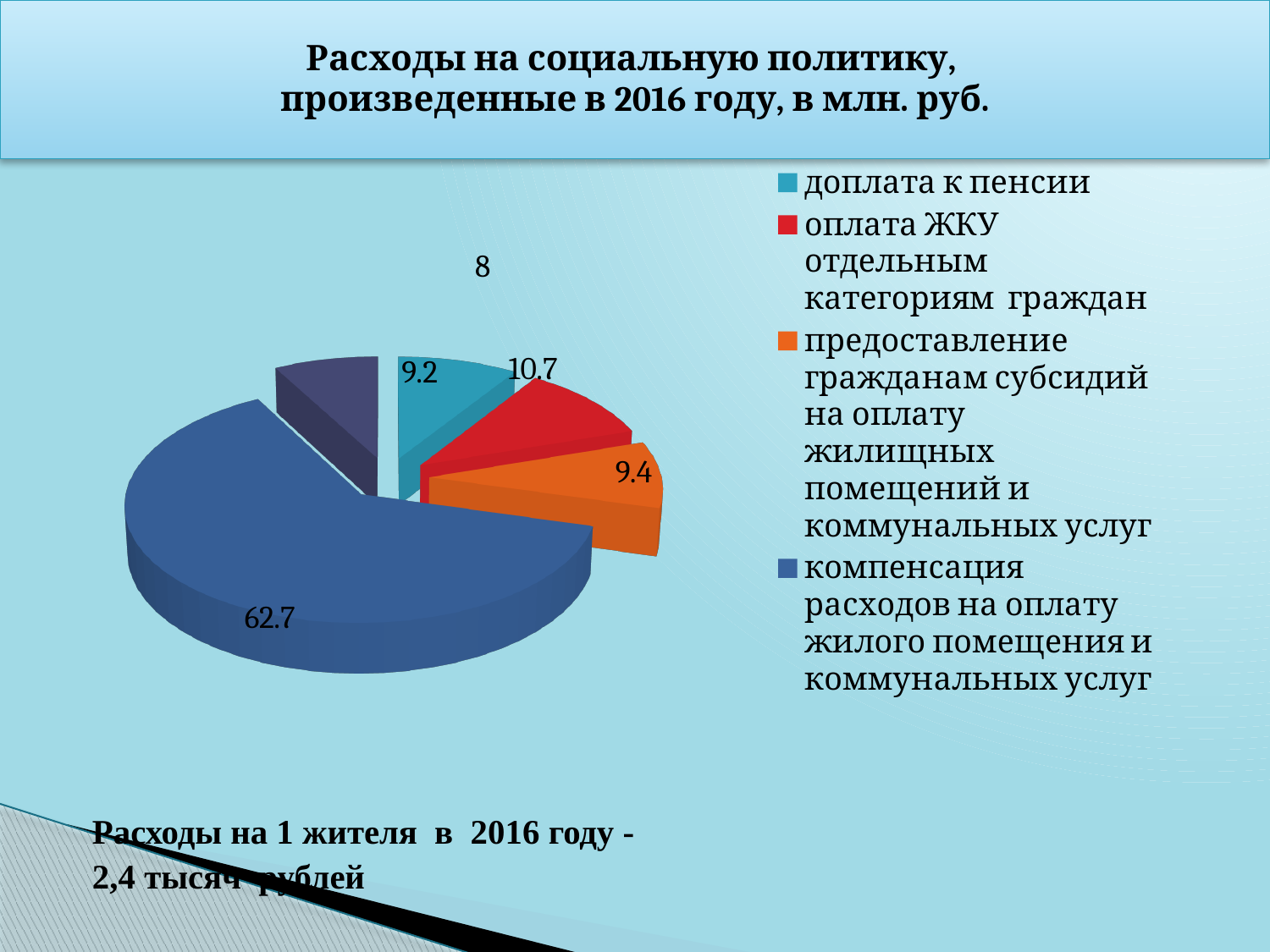
Which is larger: "оплата ЖКУ отдельным категориям граждан" or "предоставление гражданам субсидий на оплату жилищных помещений и коммунальных услуг"? оплата ЖКУ отдельным категориям граждан What is the difference between the values for "оплата ЖКУ отдельным категориям граждан" and "доплата к пенсии"? 1.5 What is the difference between the values for "компенсация расходов на оплату жилого помещения и коммунальных услуг" and "оплата ЖКУ отдельным категориям граждан"? 52 How many categories does the legend list? 4 What colour is the slice for "компенсация расходов на оплату жилого помещения и коммунальных услуг"? dark blue What is the value for "оплата ЖКУ отдельным категориям граждан"? 10.7 What kind of chart is shown on the slide? pie chart What is the title of the chart? Расходы на социальную политику, произведенные в 2016 году, в млн. руб. Which category has the largest slice of the pie? компенсация расходов на оплату жилого помещения и коммунальных услуг What is the value for "компенсация расходов на оплату жилого помещения и коммунальных услуг"? 62.7 What is the value for "предоставление гражданам субсидий на оплату жилищных помещений и коммунальных услуг"? 9.4 What is the value for "доплата к пенсии"? 9.2